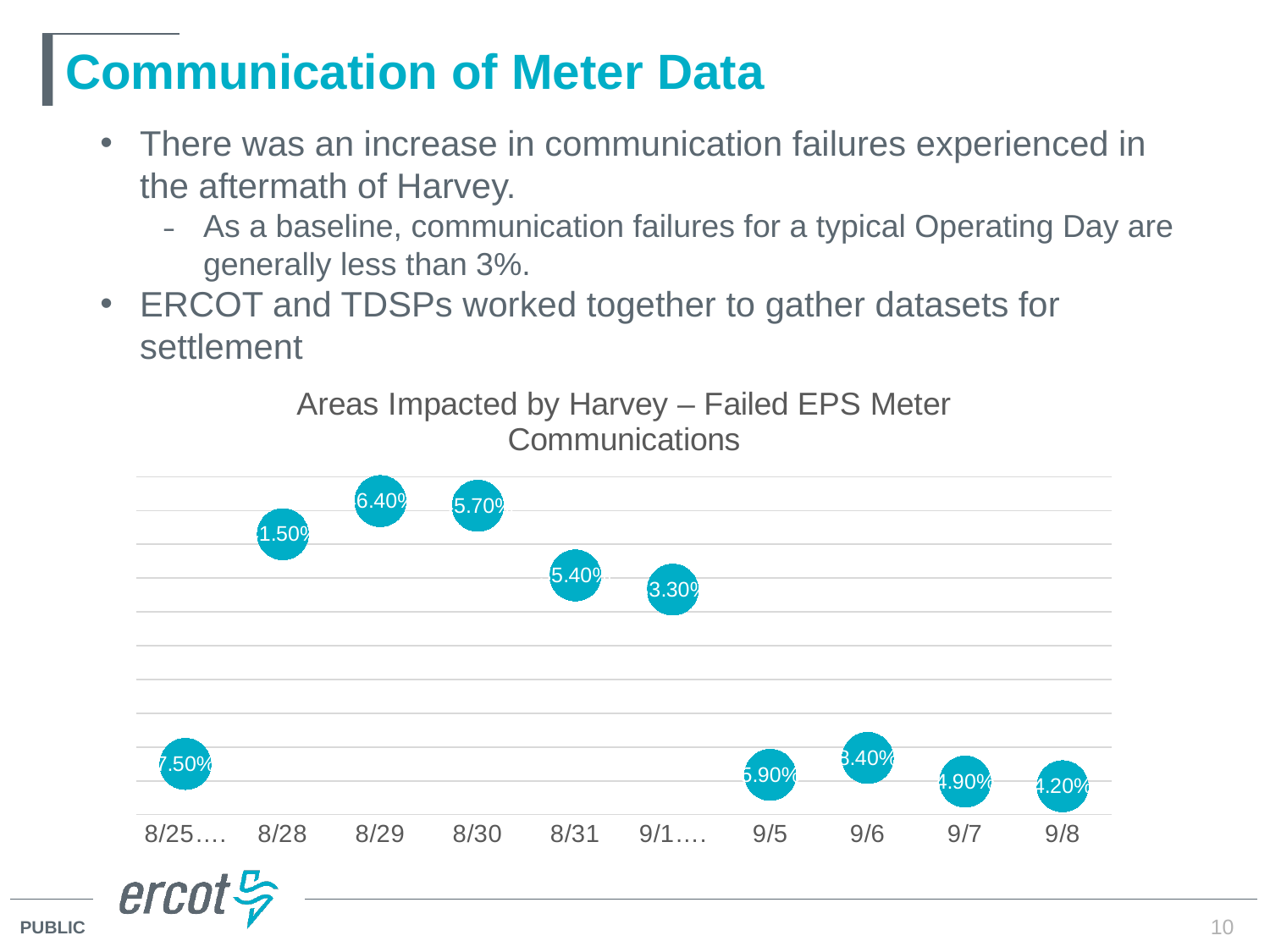
What is the title of the chart on the slide? Areas Impacted by Harvey – Failed EPS Meter Communications What kind of chart is shown on the slide? A line chart drawn with markers only (dots, no connecting lines) How many dates are plotted along the x axis of the chart? 10 Do the plotted values rise or fall from 8/29 to 9/1 in the chart? Fall Which is higher in the chart, the value for 8/29 or the value for 9/5? 8/29 Which is higher in the chart, the value for 9/1 or the value for 9/6? 9/1 What is the first date shown on the x axis of the chart? 8/25 Do the plotted values rise or fall from 8/25 to 8/29 in the chart? Rise Which date has the highest plotted value in the chart? 8/29 Which is higher in the chart, the value for 8/28 or the value for 8/31? 8/28